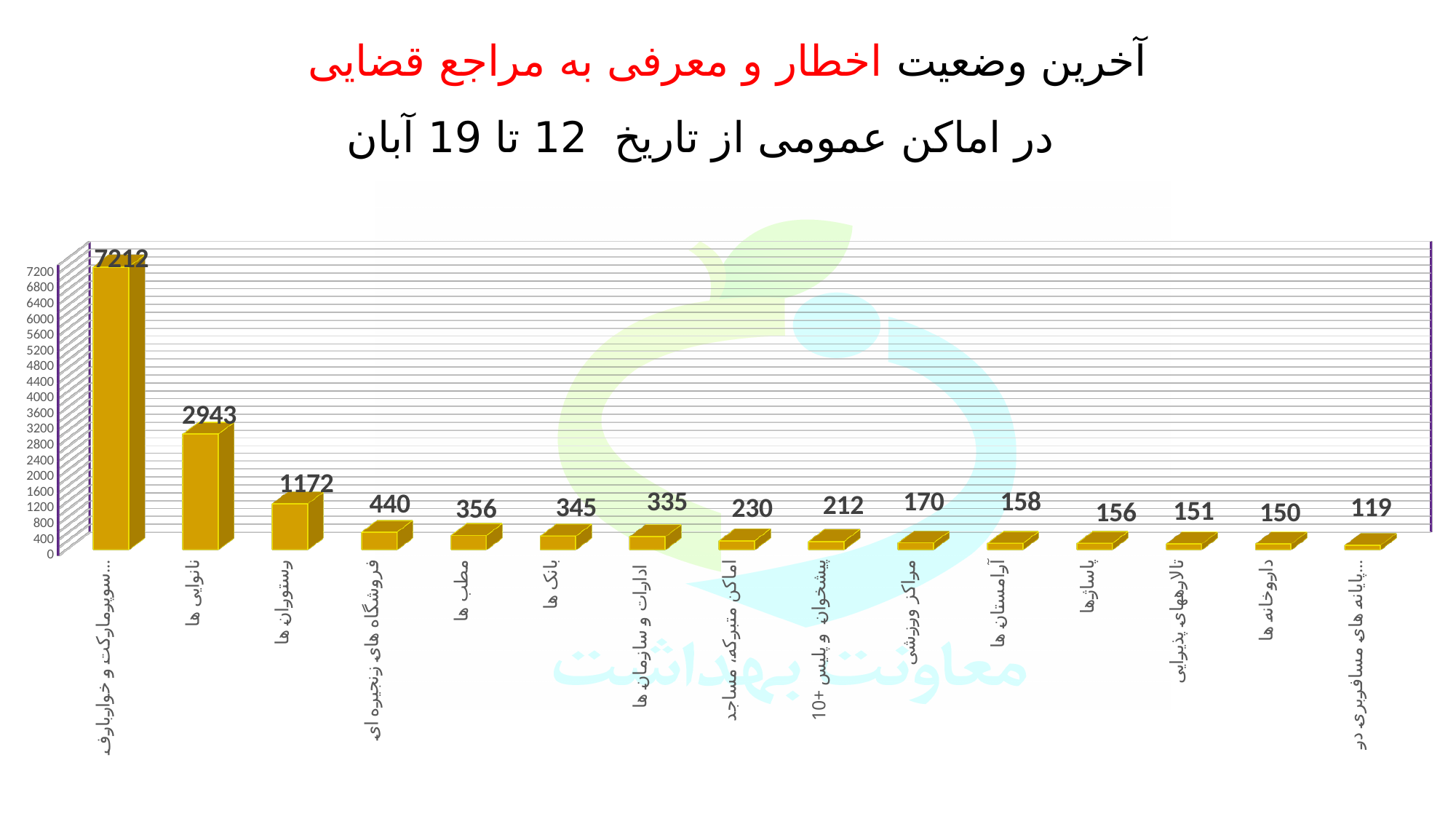
Which is larger, the value for مطب ها or the value for ادارات و سازمان ها? مطب ها What kind of chart is shown on the slide? bar chart What is the value for رستوران ها? 1172 What is the value for نانوایی ها? 2943 What is the difference between the values for فروشگاه های زنجیره ای and مراکز ورزشی? 270 Which category has the highest value? سوپرمارکت و خواربارفروشی Which category has the lowest value? پایانه های مسافربری What is the value for داروخانه ها? 150 What is the difference between the values for نانوایی ها and رستوران ها? 1771 What is the value for بانک ها? 345 Do the values rise or fall from left to right along the x axis? fall How many categories are shown in the chart? 15